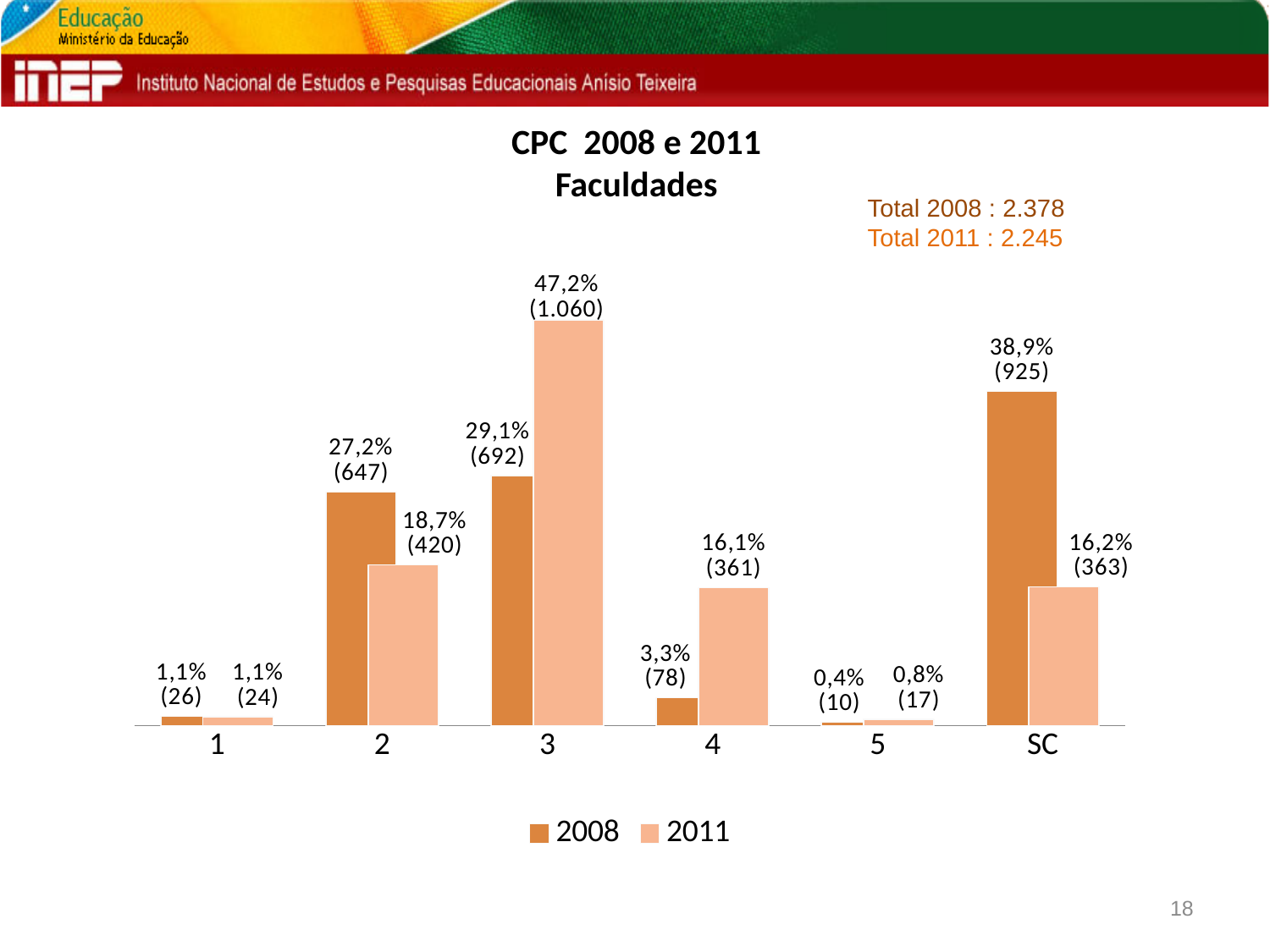
What is the total for 2011 stated on the slide? 2.245 What is the difference in percentage points between the 2008 and 2011 values for category 2? 8,5 What is the 2008 value for category SC? 38,9% (925) What kind of chart is shown on the slide? bar chart Which is larger for category 4, the 2008 value or the 2011 value? 2011 Which category has the highest 2008 value? SC How many series does the legend list? 2 Which category has the lowest 2011 value? 5 What is the 2011 value for category 5? 0,8% (17) What is the 2011 value for category 3? 47,2% (1.060) What is the 2008 value for category 4? 3,3% (78) How many categories are shown on the x axis? 6